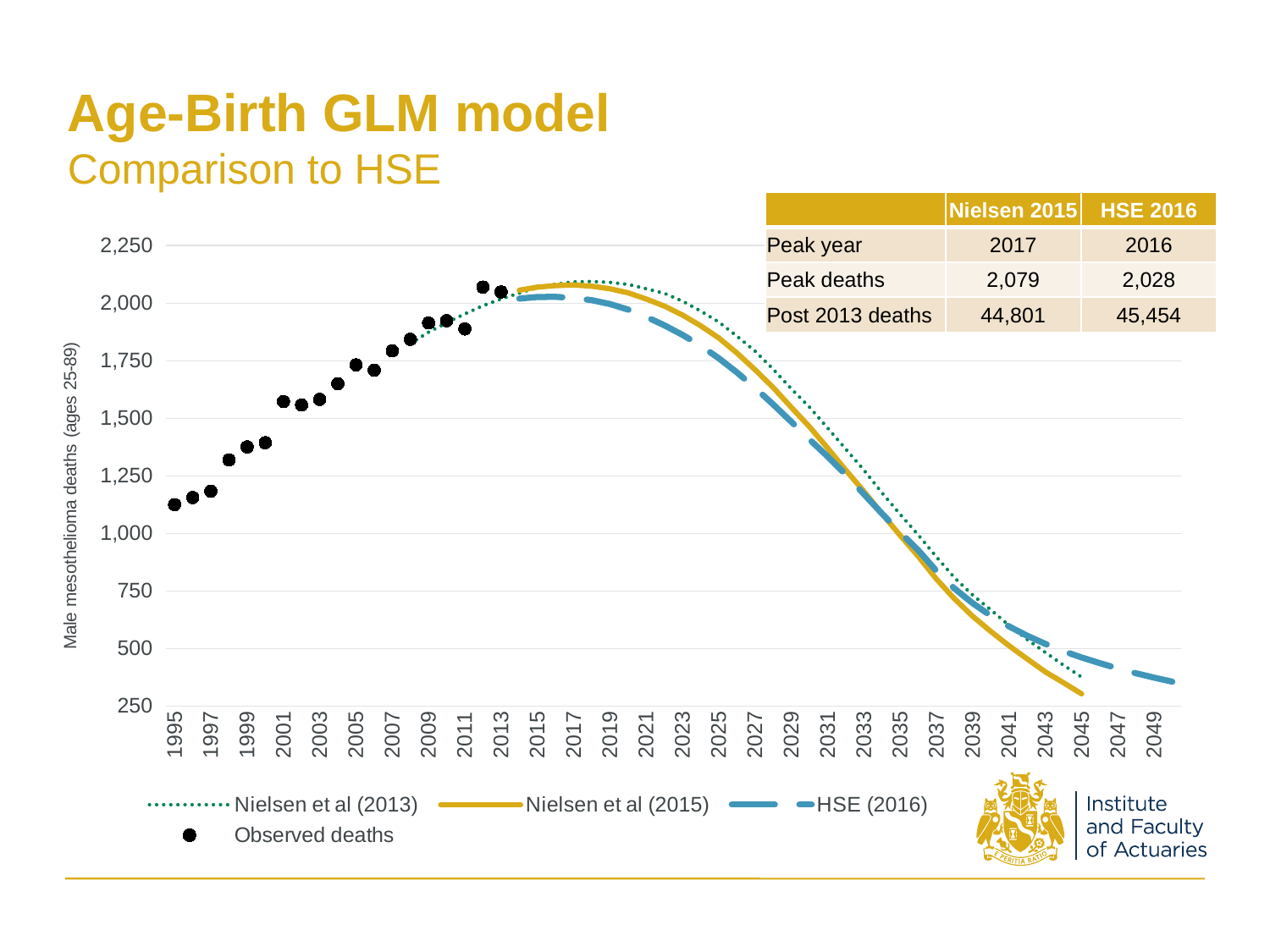
According to the table on the slide, what is the difference in post 2013 deaths between HSE 2016 and Nielsen 2015? 653 Is the HSE (2016) projection for 2049 greater or less than 500? less What kind of chart is shown on the slide? line chart How many series does the chart legend list? 4 Is the HSE (2016) projection for 2041 greater or less than 750? less According to the table on the slide, what is the peak year for Nielsen 2015? 2017 Do the observed deaths rise or fall between 1995 and 2013? rise Is the observed deaths value for 2012 greater or less than 2,000? greater Which series in the legend is drawn as black dots? Observed deaths In 2045, which projection is higher: HSE (2016) or Nielsen et al (2015)? HSE (2016) What is the label of the vertical axis of the chart? Male mesothelioma deaths (ages 25-89)